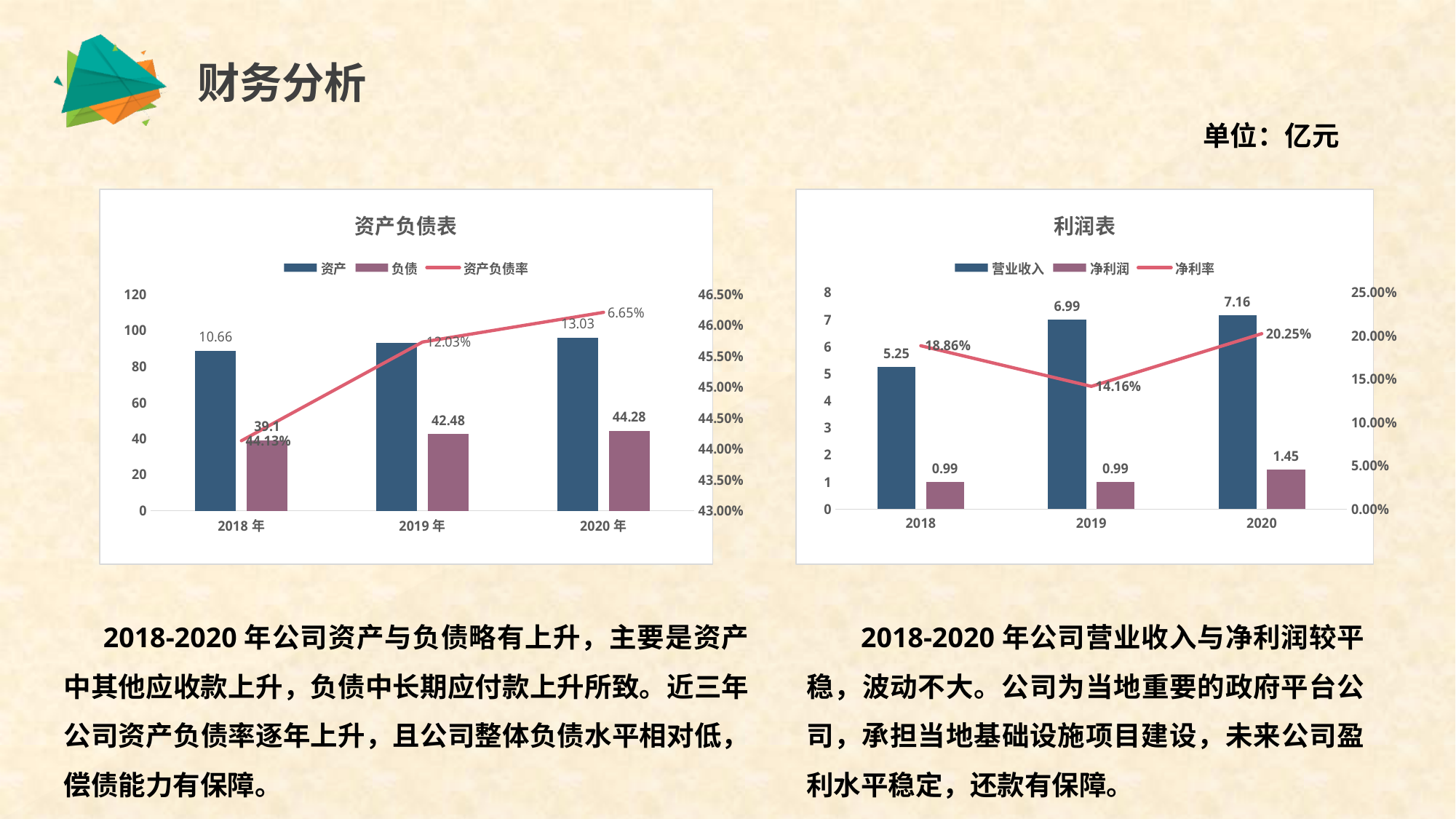
In the 资产负债表 chart, which is larger in 2020, 资产 or 负债? 资产 In the 资产负债表 chart, is the 资产 value for 2018 greater or less than 80? greater In the 资产负债表 chart, do the 负债 values rise or fall from 2018 to 2020? rise In the 利润表 chart, what is the 营业收入 value for 2020? 7.16 In the 利润表 chart, which year has the lowest 净利率? 2019 In the 利润表 chart, what is the 净利率 for 2019? 14.16% In the 利润表 chart, by how much did 营业收入 increase from 2018 to 2019? 1.74 In the 资产负债表 chart, what is the difference in 负债 between 2020 and 2018? 5.18 In the 利润表 chart, what is the difference in 净利润 between 2020 and 2019? 0.46 How many series does the legend of the 资产负债表 chart list? 3 In the 资产负债表 chart, what is the 负债 value for 2019? 42.48 In the 利润表 chart, which year has the highest 营业收入? 2020